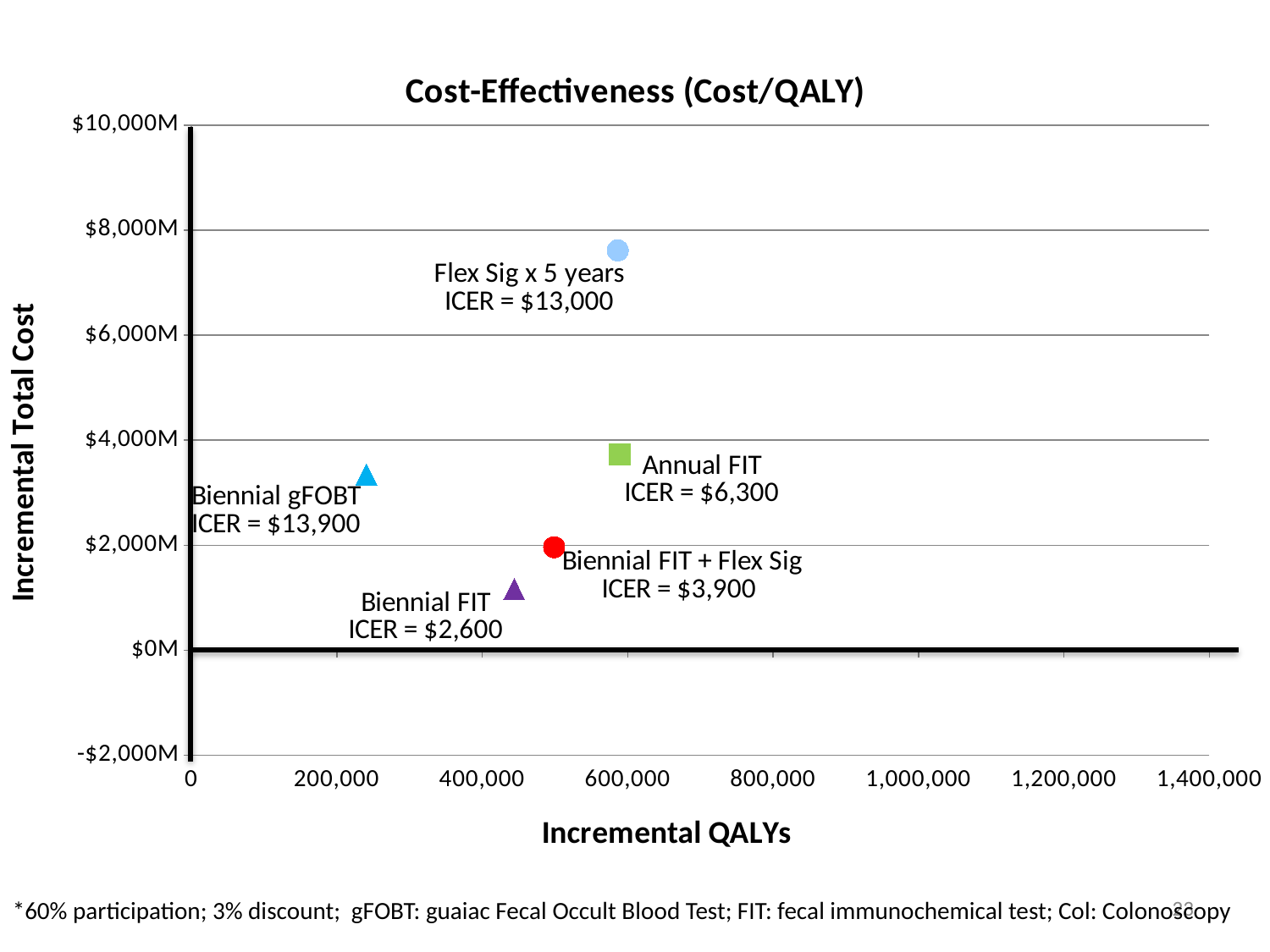
Are the incremental QALYs for Biennial gFOBT greater or less than 400,000? less Which strategy has the highest incremental total cost? Flex Sig x 5 years Which strategy has the lowest incremental total cost? Biennial FIT What kind of chart is shown on the slide? Scatter chart What is the title of the chart? Cost-Effectiveness (Cost/QALY) What is the ICER printed for Biennial FIT? $2,600 What is the ICER printed for Flex Sig x 5 years? $13,000 What is the ICER printed for Annual FIT? $6,300 How many screening strategies are plotted as points on the chart? 5 Which has the higher incremental total cost, Annual FIT or Biennial FIT + Flex Sig? Annual FIT Is the incremental total cost for Flex Sig x 5 years greater or less than $6,000M? greater What is the ICER printed for Biennial gFOBT? $13,900